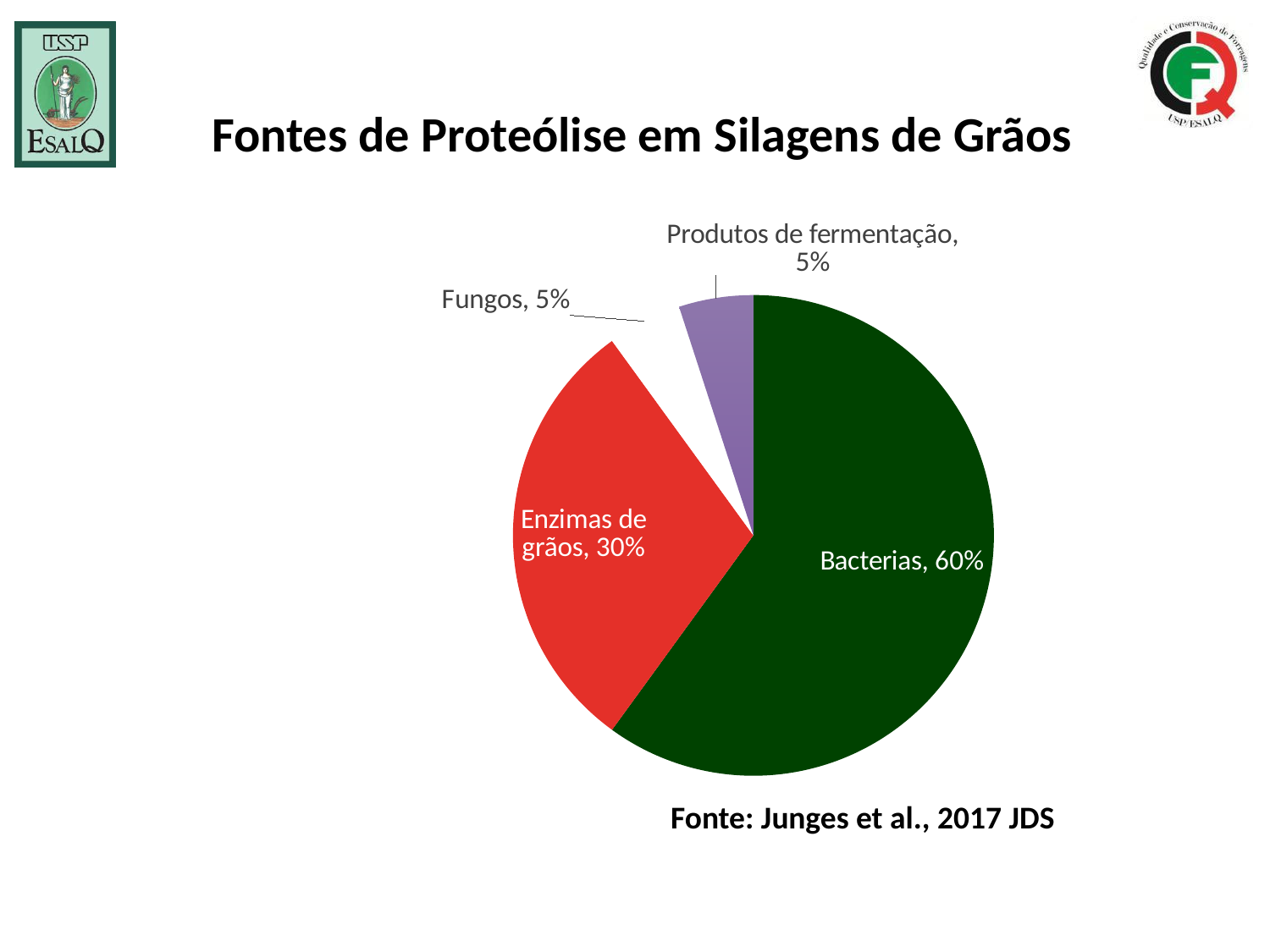
What is the combined share of Fungos and Produtos de fermentação? 10% How many categories are shown in the pie chart? 4 What is the share for Produtos de fermentação in the pie chart? 5% What is the share for Fungos in the pie chart? 5% What kind of chart is shown on the slide? pie chart Which is larger, the share for Enzimas de grãos or the share for Fungos? Enzimas de grãos What is the title of the chart on the slide? Fontes de Proteólise em Silagens de Grãos What is the share for Enzimas de grãos in the pie chart? 30% What colour is the Bacterias slice in the pie chart? dark green What is the share for Bacterias in the pie chart? 60% What is the difference in percentage points between Bacterias and Enzimas de grãos? 30 Which category has the largest slice of the pie chart? Bacterias